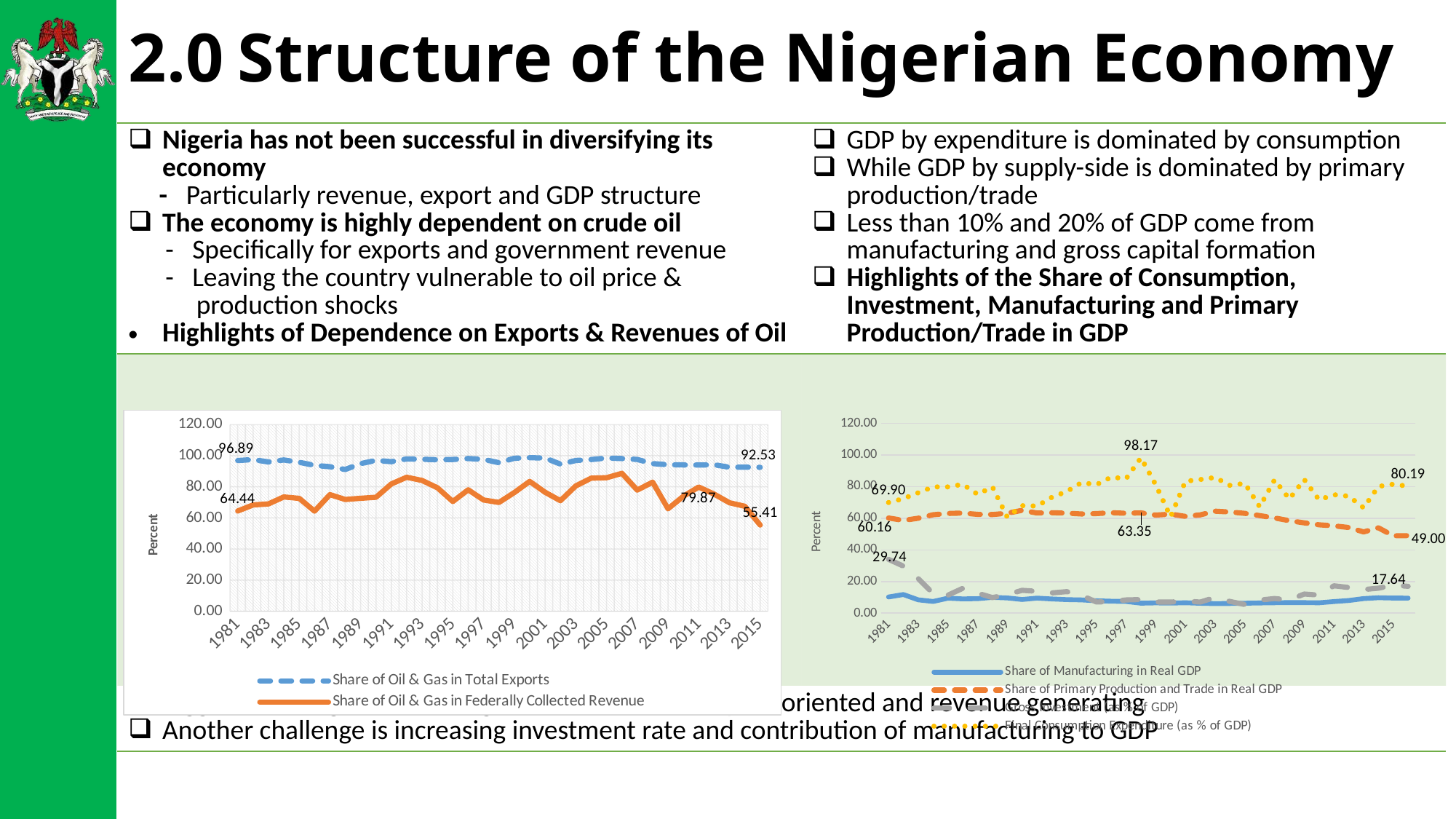
In the left chart, what is the difference between the 1981 and 2015 labelled values for Share of Oil & Gas in Total Exports? 4.36 How many series does the legend of the right chart list? 4 How many series does the legend of the left chart list? 2 In the left chart, what is the data label shown for Share of Oil & Gas in Federally Collected Revenue in 2015? 55.41 What type of chart is the left chart? Line chart In the right chart, what is the highest labelled value for Final Consumption Expenditure (as % of GDP)? 98.17 In the left chart, what is the data label shown for Share of Oil & Gas in Total Exports in 2015? 92.53 In the left chart, which series is higher in 2015: Share of Oil & Gas in Total Exports or Share of Oil & Gas in Federally Collected Revenue? Share of Oil & Gas in Total Exports In the left chart, what is the data label shown for Share of Oil & Gas in Total Exports at the start of the series in 1981? 96.89 In the left chart, what is the data label shown for Share of Oil & Gas in Federally Collected Revenue in 1981? 64.44